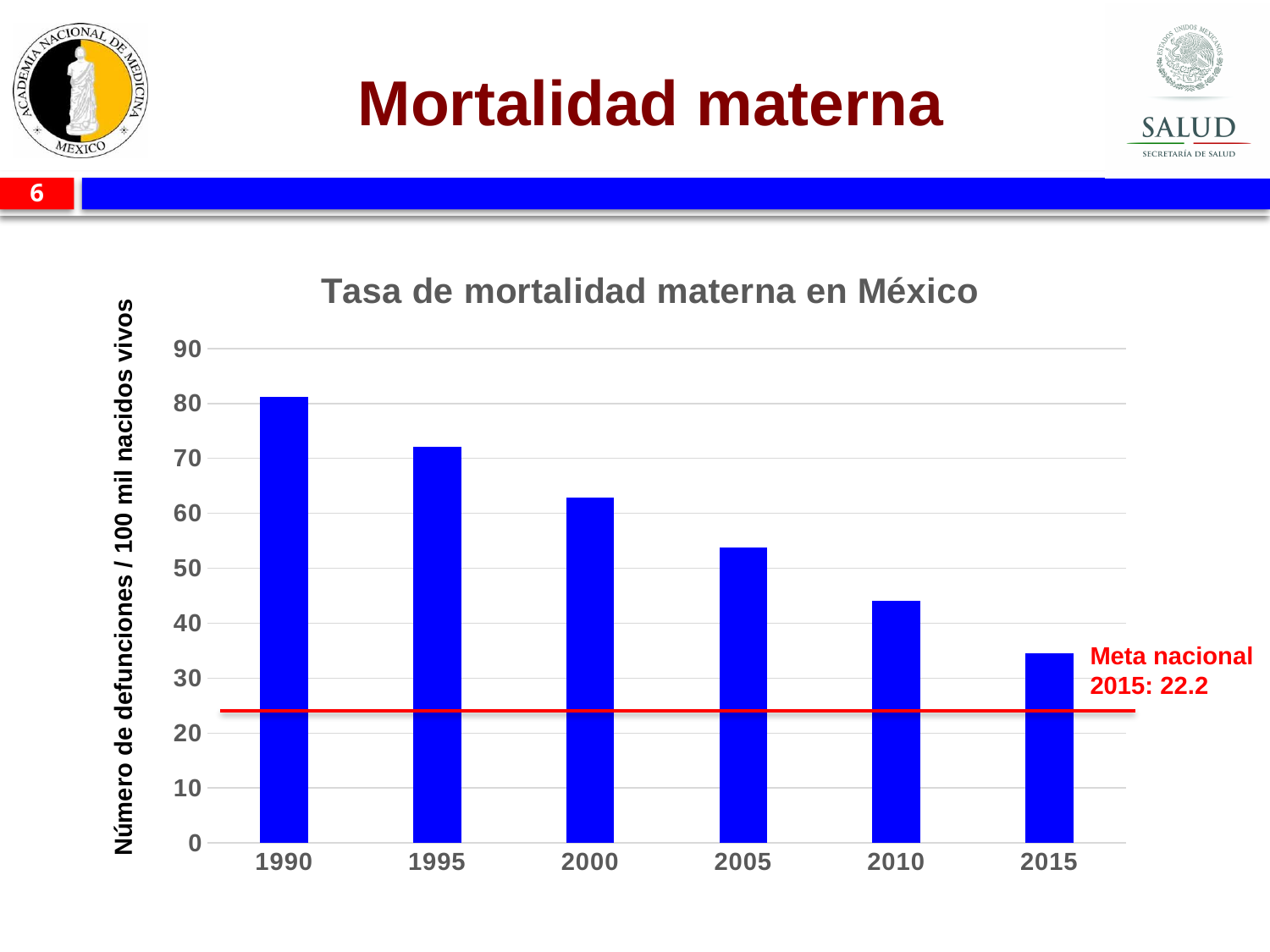
What is the national target (Meta nacional) for 2015 shown on the chart? 22.2 How many years are plotted on the x axis of the chart? 6 What kind of chart is shown on the slide? bar chart Do the values rise or fall from 1990 to 2015 along the x axis? fall Which year has the lowest maternal mortality rate in the chart? 2015 Which is larger, the value for 1995 or the value for 2005? 1995 Is the value for 2010 greater or less than 50? less Which year has the highest maternal mortality rate in the chart? 1990 Is the value for 2015 greater or less than 40? less Is the value for 2000 greater or less than 60? greater What is the title of the chart? Tasa de mortalidad materna en México